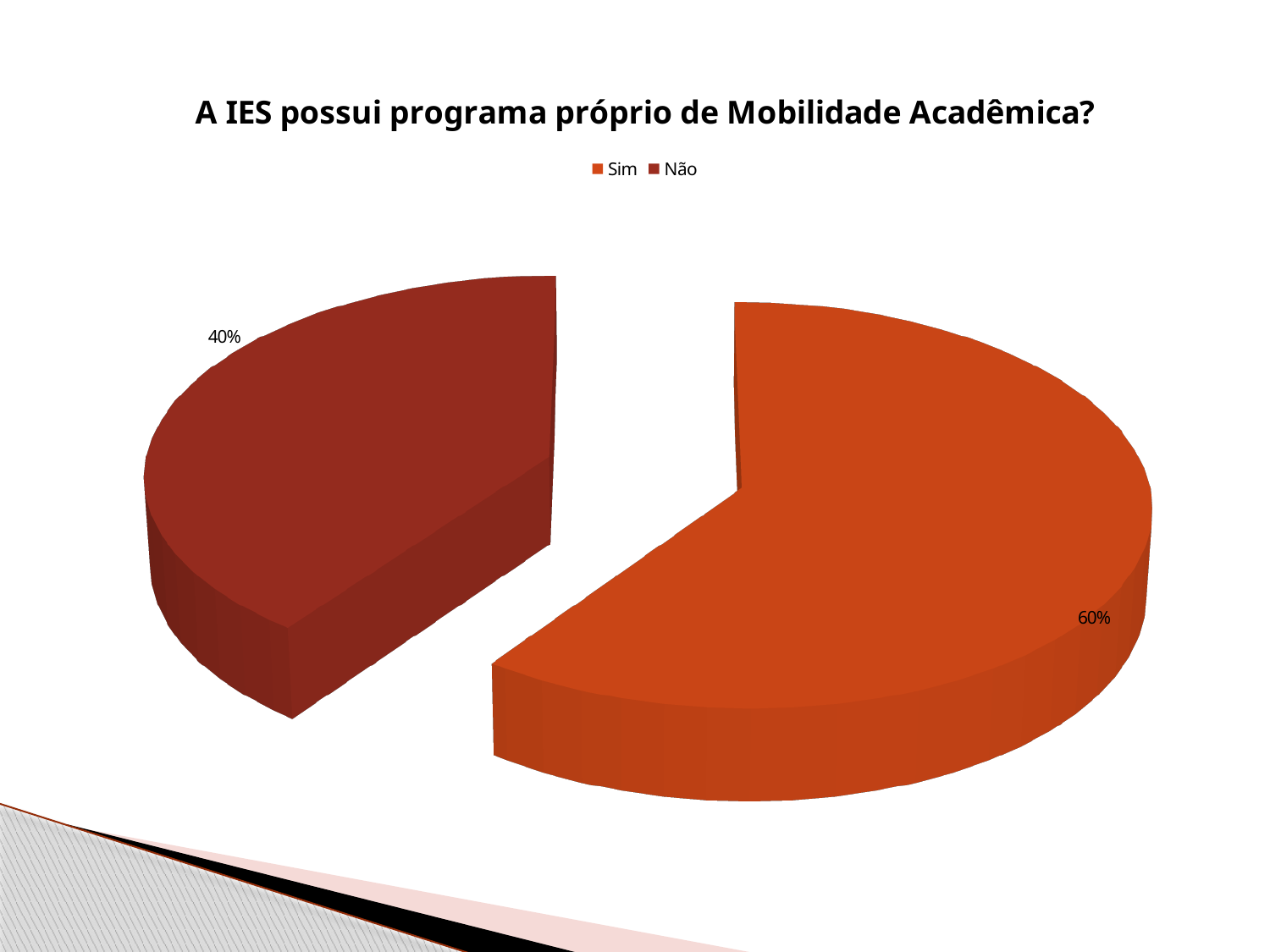
What share of the pie does the "Sim" slice represent? 60% How many slices does the pie chart have? 2 What is the title of the chart? A IES possui programa próprio de Mobilidade Acadêmica? What is the difference in percentage points between the "Sim" and "Não" slices? 20% Which slice is the largest? Sim Which is larger, the "Sim" slice or the "Não" slice? Sim What kind of chart is shown on the slide? pie chart Which legend entry is shown in the darker red colour? Não What share of the pie does the "Não" slice represent? 40% Which slice is the smallest? Não How many entries does the legend list? 2